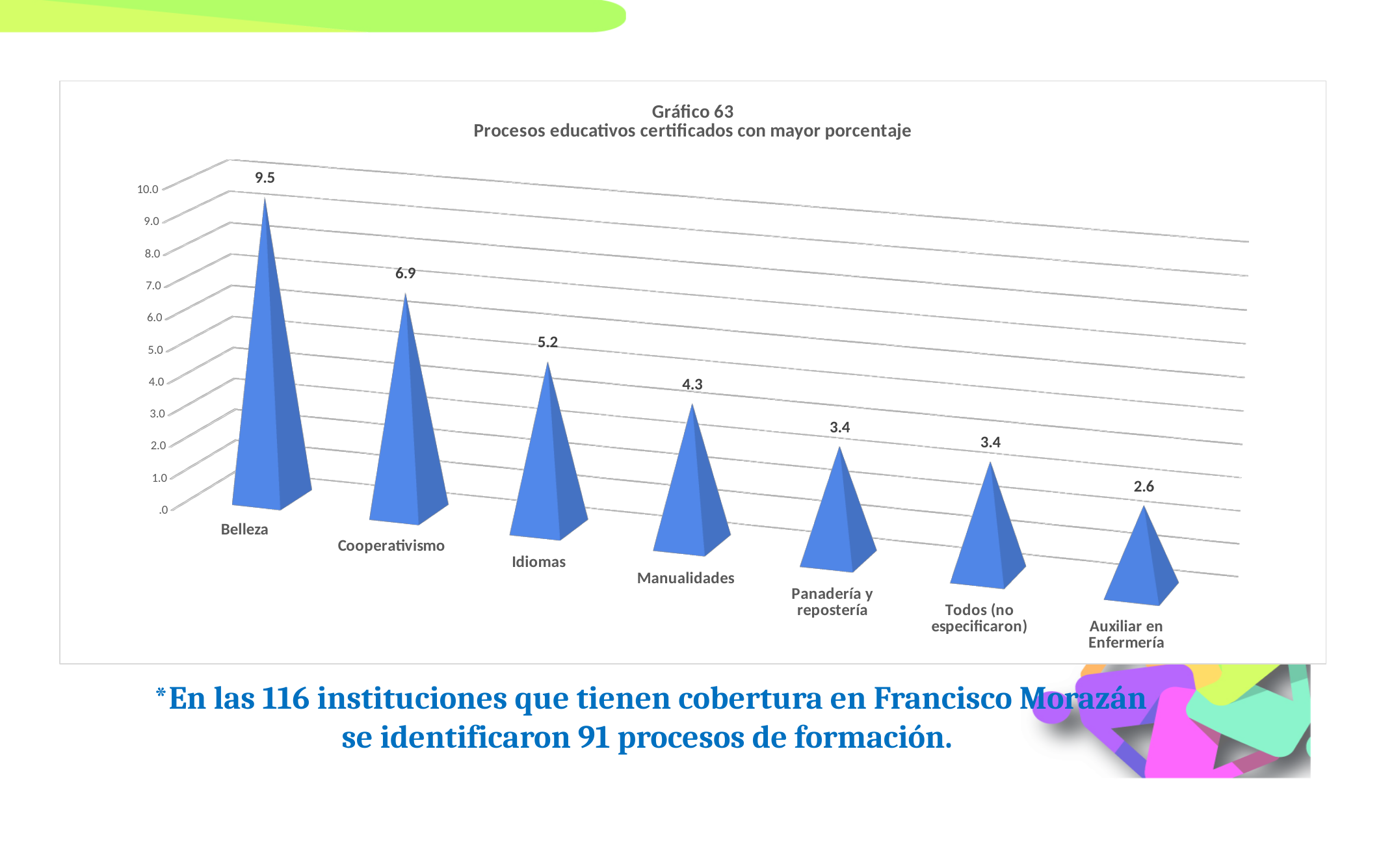
Which category has the lowest value? Auxiliar en Enfermería What is the title of the chart? Gráfico 63 Procesos educativos certificados con mayor porcentaje What is the value for Auxiliar en Enfermería? 2.6 What is the value for Cooperativismo? 6.9 What is the difference between the values for Belleza and Cooperativismo? 2.6 How many categories are shown in the chart? 7 Which is larger, the value for Idiomas or the value for Manualidades? Idiomas Which category has the highest value? Belleza What is the value for Manualidades? 4.3 What is the value for Idiomas? 5.2 Do the values rise or fall from left to right along the x axis? fall What is the value for Belleza? 9.5